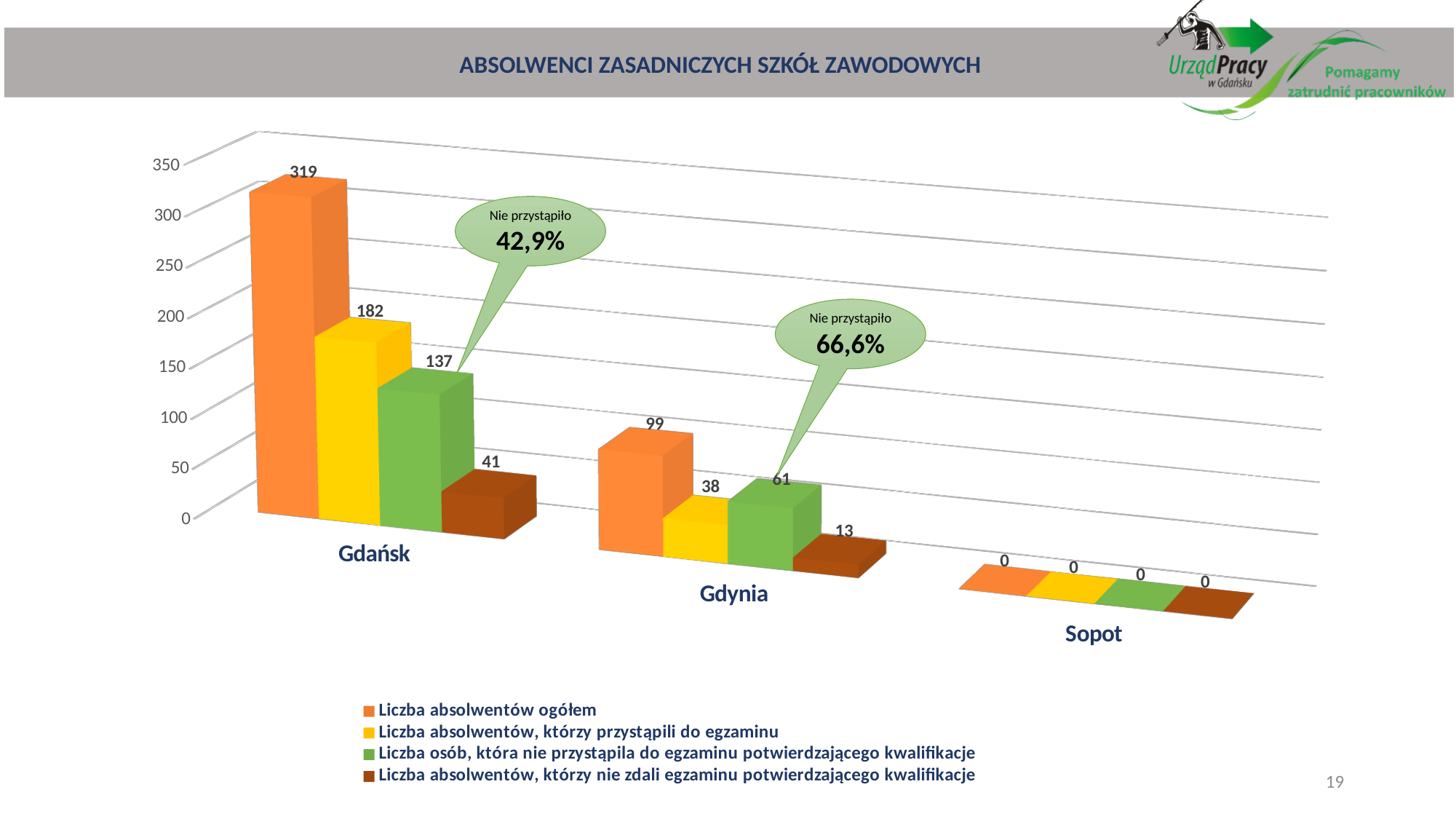
How many series does the legend list? 4 What is the difference between 'Liczba absolwentów ogółem' for Gdańsk and Gdynia? 220 Which is larger for Gdynia: 'Liczba absolwentów, którzy przystąpili do egzaminu' or 'Liczba osób, która nie przystąpiła do egzaminu potwierdzającego kwalifikacje'? Liczba osób, która nie przystąpiła do egzaminu potwierdzającego kwalifikacje Which city has the lowest value for 'Liczba absolwentów ogółem'? Sopot What is the value of 'Liczba absolwentów ogółem' for Gdańsk? 319 What kind of chart is shown on the slide? bar chart What is the value of 'Liczba absolwentów, którzy przystąpili do egzaminu' for Gdynia? 38 How many cities are shown on the x axis? 3 Which city has the highest value for 'Liczba absolwentów ogółem'? Gdańsk What is the value of 'Liczba absolwentów, którzy nie zdali egzaminu potwierdzającego kwalifikacje' for Gdańsk? 41 What is the value of 'Liczba osób, która nie przystąpiła do egzaminu potwierdzającego kwalifikacje' for Gdynia? 61 What percentage is shown in the 'Nie przystąpiło' callout for Gdynia? 66,6%